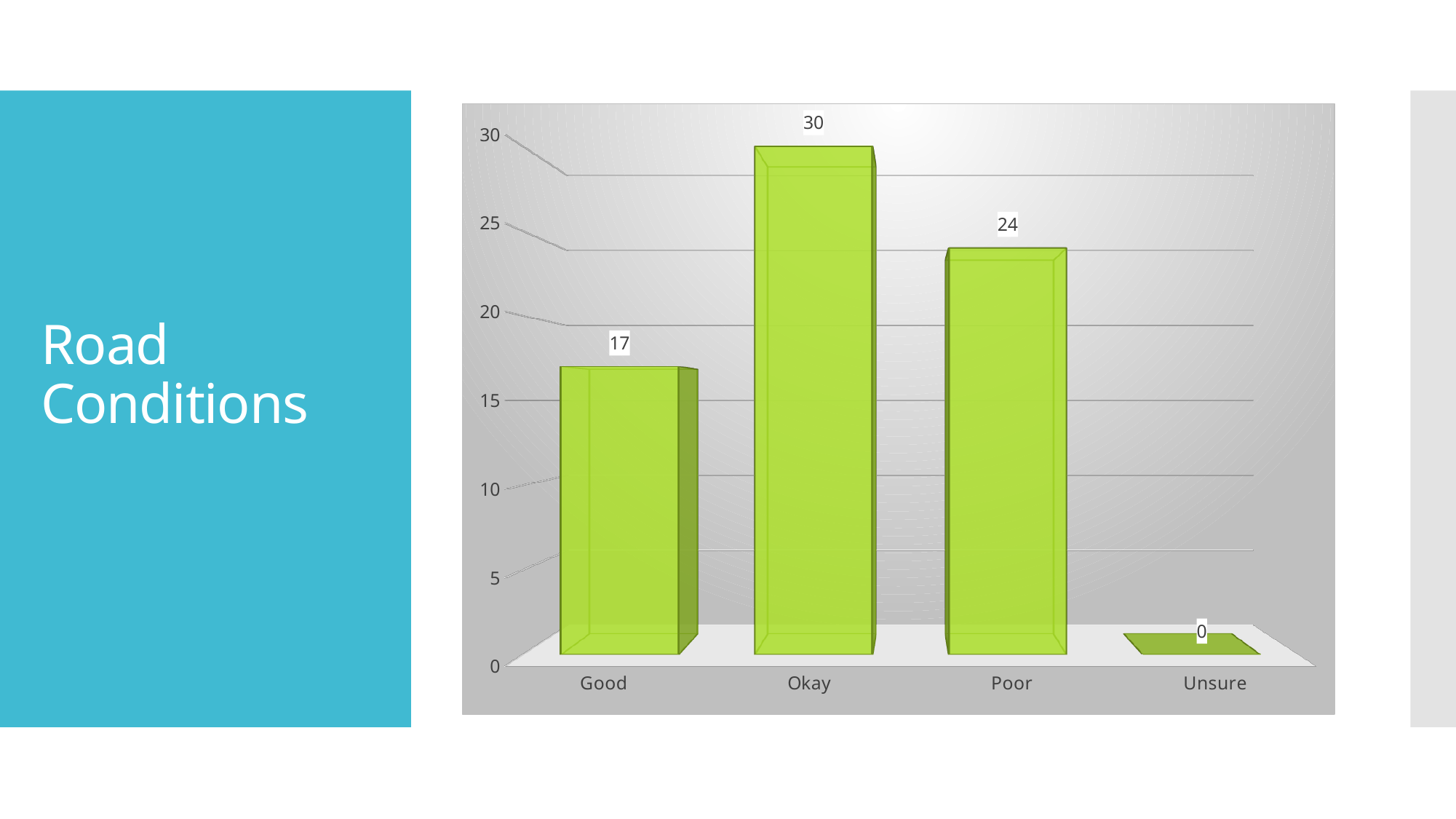
What is the title of the slide containing the chart? Road Conditions How many categories are shown on the x axis? 4 Which category has the highest value? Okay Which is larger, the value for Good or the value for Poor? Poor What is the value for Unsure? 0 Which category has the lowest value? Unsure What kind of chart is shown on the slide? Bar chart What is the value for Okay? 30 What is the value for Good? 17 What is the difference between the values for Okay and Poor? 6 What is the difference between the values for Poor and Good? 7 What is the value for Poor? 24